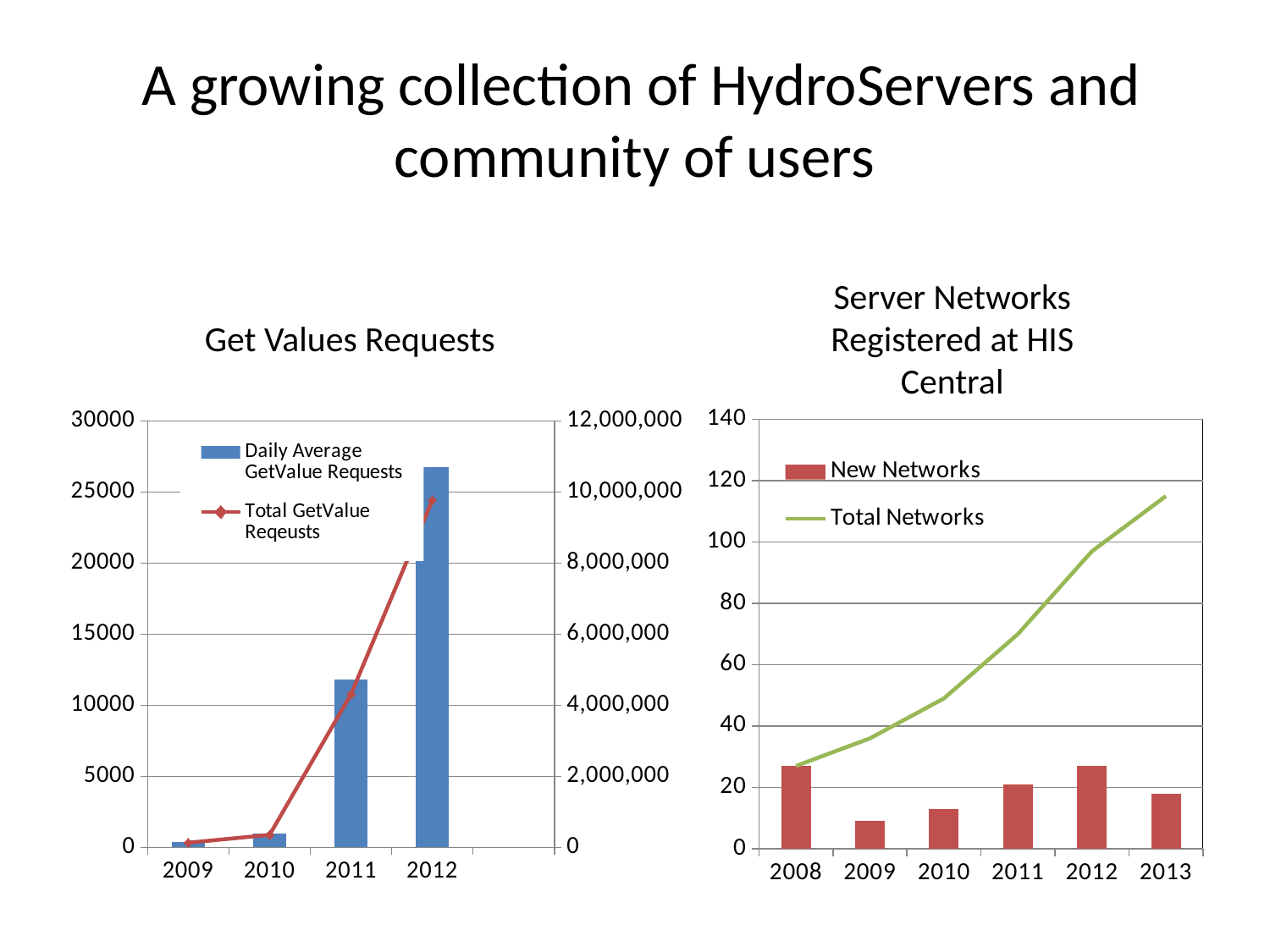
In the Get Values Requests chart, do the Total GetValue Requests rise or fall from 2009 to 2012? rise In the Server Networks Registered at HIS Central chart, which is larger, New Networks in 2011 or in 2009? 2011 In the Get Values Requests chart, what kind of chart is used for the Daily Average GetValue Requests series? bar chart In the Server Networks Registered at HIS Central chart, is the Total Networks value for 2013 greater or less than 100? greater In the Get Values Requests chart, how many years are shown on the x axis? 4 In the Server Networks Registered at HIS Central chart, how many years are shown on the x axis? 6 In the Get Values Requests chart, which year has the lowest Daily Average GetValue Requests? 2009 In the Server Networks Registered at HIS Central chart, which year has the lowest number of New Networks? 2009 In the Get Values Requests chart, how many series does the legend list? 2 In the Get Values Requests chart, which year has the highest Daily Average GetValue Requests? 2012 In the Get Values Requests chart, is the Daily Average GetValue Requests value for 2012 greater or less than 25000? greater In the Get Values Requests chart, is the Daily Average GetValue Requests value for 2010 greater or less than 5000? less